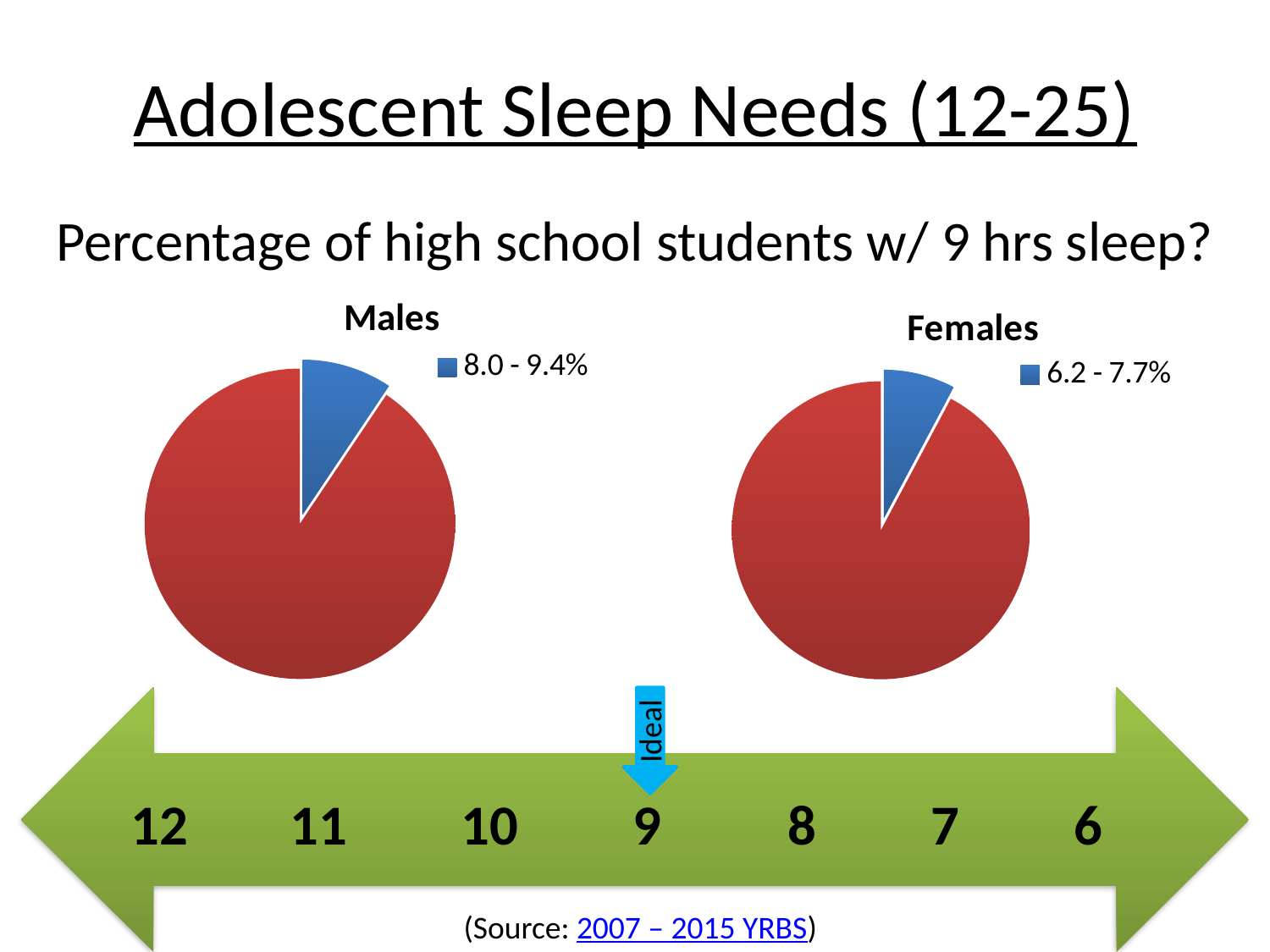
How many slices does the Females pie chart have? 2 What kind of chart is the Males chart? pie chart In the Males chart, what does the legend entry say? 8.0 - 9.4% How many entries does the legend of the Males chart list? 1 How many entries does the legend of the Females chart list? 1 How many slices does the Males pie chart have? 2 What is the title of the right chart? Females What is the title of the left chart? Males In the Males chart, which slice is larger, the blue slice or the red slice? the red slice In the Females chart, what does the legend entry say? 6.2 - 7.7% In the Females chart, which slice is larger, the blue slice or the red slice? the red slice What kind of chart is the Females chart? pie chart